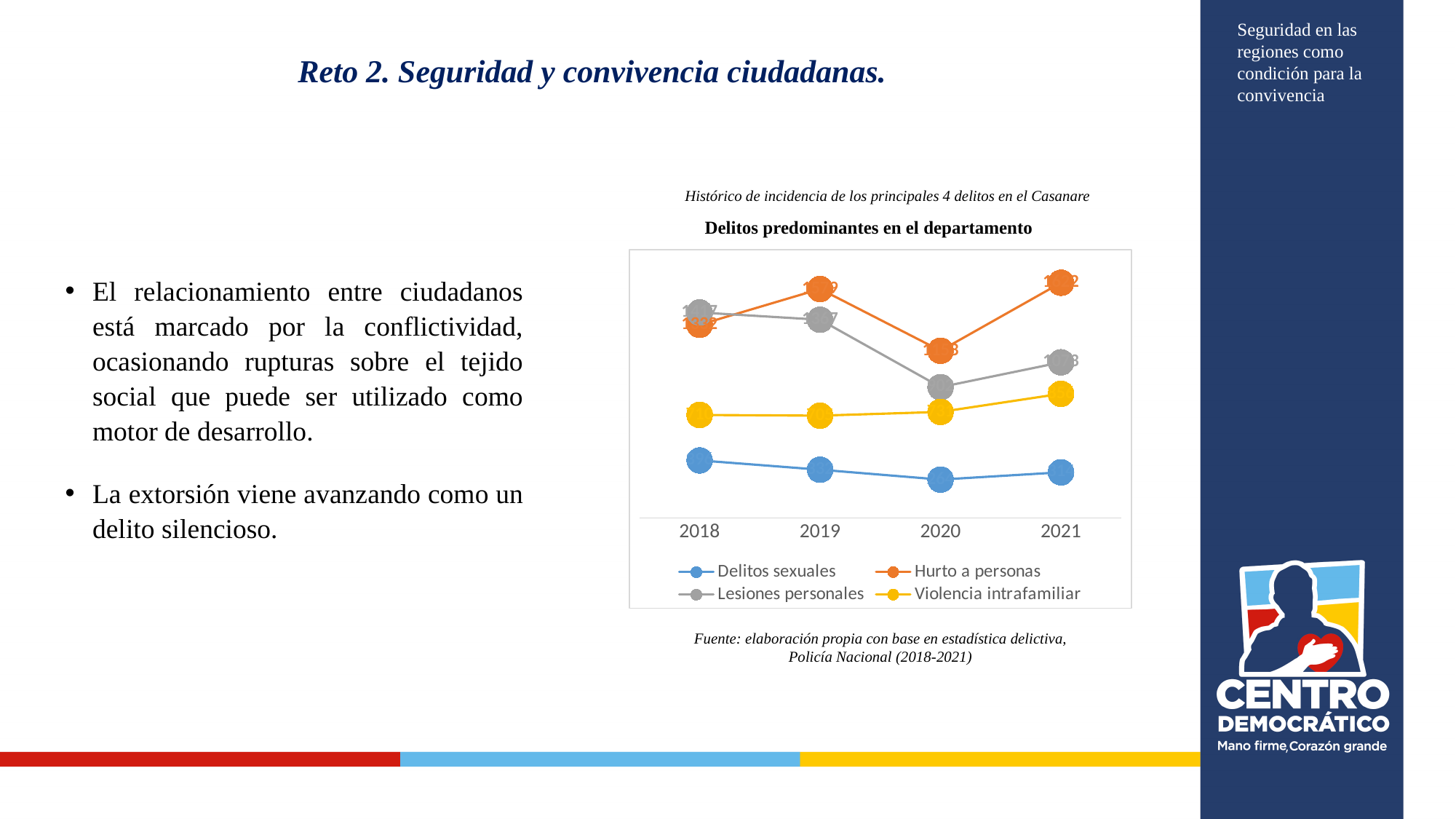
Does the Hurto a personas series rise or fall from 2020 to 2021? Rise How many years are shown on the x axis of the chart? 4 In which year is the Hurto a personas series at its highest? 2021 In 2020, which is larger: Lesiones personales or Violencia intrafamiliar? Lesiones personales What kind of chart is shown under the title "Delitos predominantes en el departamento"? Line chart How many series does the legend of the chart list? 4 Which series has the highest value in 2019? Hurto a personas Which series has the lowest value in 2021? Delitos sexuales Which series has the highest value in 2021? Hurto a personas In which year is the Lesiones personales series at its lowest? 2020 Does the Delitos sexuales series rise or fall from 2018 to 2020? Fall What colour is the line for Violencia intrafamiliar? Yellow